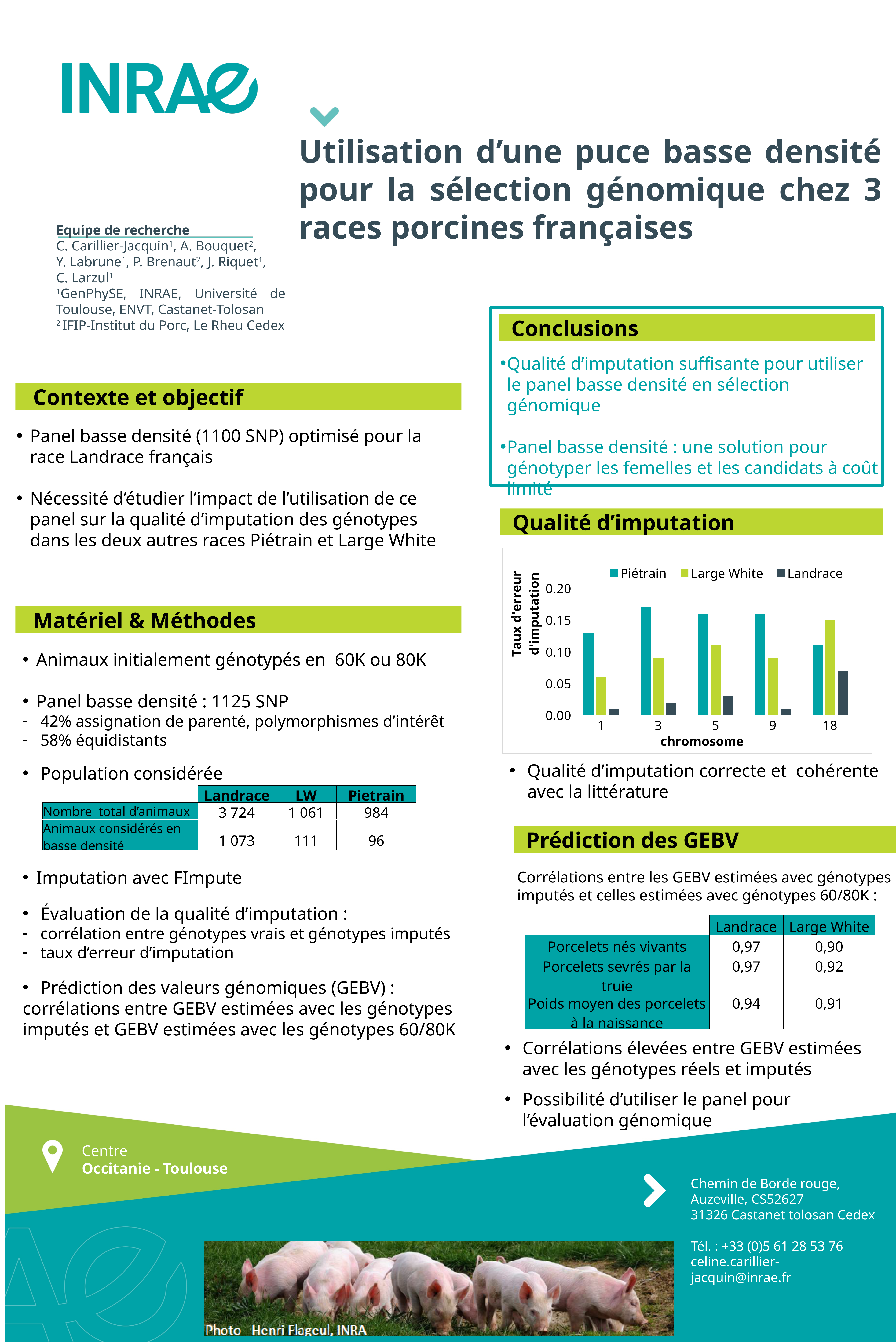
How many series does the legend of the 'Qualité d'imputation' chart list? 3 In the 'Qualité d'imputation' chart, is the Landrace error rate for chromosome 5 greater or less than 0.05? less In the 'Qualité d'imputation' chart, at chromosome 1, which series has the higher error rate: Piétrain or Large White? Piétrain In the 'Qualité d'imputation' chart, for which chromosome is the Piétrain error rate lowest? 18 What is the x-axis label of the 'Qualité d'imputation' chart? chromosome How many chromosomes are shown on the x axis of the 'Qualité d'imputation' chart? 5 What kind of chart is shown under 'Qualité d'imputation'? bar chart In the 'Qualité d'imputation' chart, for which chromosome is the Landrace error rate highest? 18 In the 'Qualité d'imputation' chart, for which chromosome is the Large White error rate highest? 18 In the 'Qualité d'imputation' chart, is the Piétrain error rate for chromosome 3 greater or less than 0.15? greater In the 'Qualité d'imputation' chart, at chromosome 18, which series has the higher error rate: Piétrain or Large White? Large White In the 'Qualité d'imputation' chart, is the Landrace error rate for chromosome 18 greater or less than 0.10? less